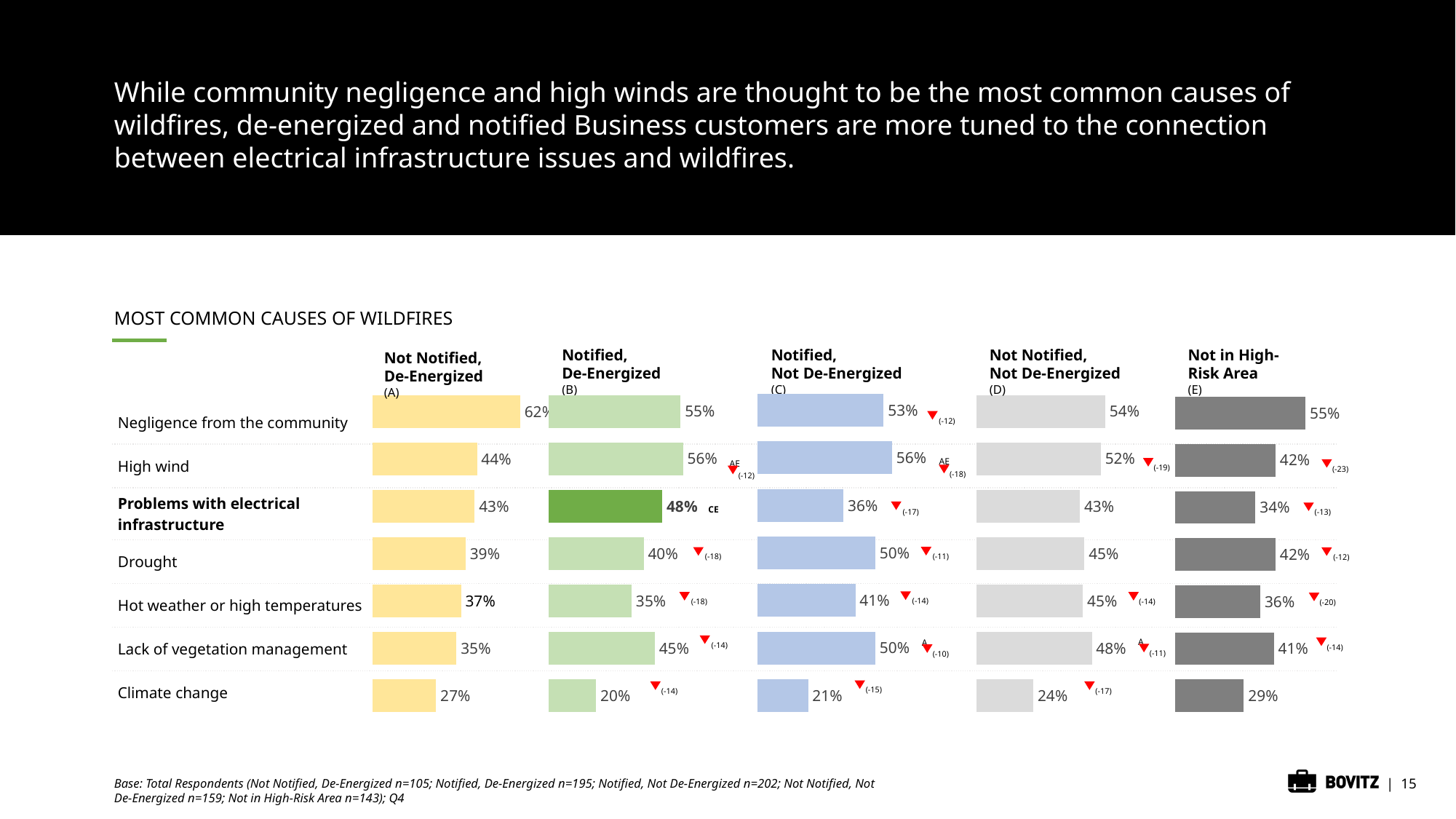
What percentage of Notified, De-Energized customers cite problems with electrical infrastructure? 48% What is the value for climate change among Not in High-Risk Area customers? 29% What percentage of Not Notified, De-Energized customers cite negligence from the community as a cause of wildfires? 62% What is the difference between the Not Notified, De-Energized and Not in High-Risk Area values for high wind? 2 percentage points Which is larger for drought: the Notified, Not De-Energized value or the Not Notified, De-Energized value? Notified, Not De-Energized What is the title of the chart? MOST COMMON CAUSES OF WILDFIRES Which cause has the highest value in the Not Notified, De-Energized column? Negligence from the community What type of chart is used to show the most common causes of wildfires? Bar chart Which cause has the lowest value in the Notified, De-Energized column? Climate change How many customer segments are compared in the chart? 5 What is the difference between the Notified, De-Energized and Notified, Not De-Energized values for problems with electrical infrastructure? 12 percentage points How many causes of wildfires are listed in the chart? 7